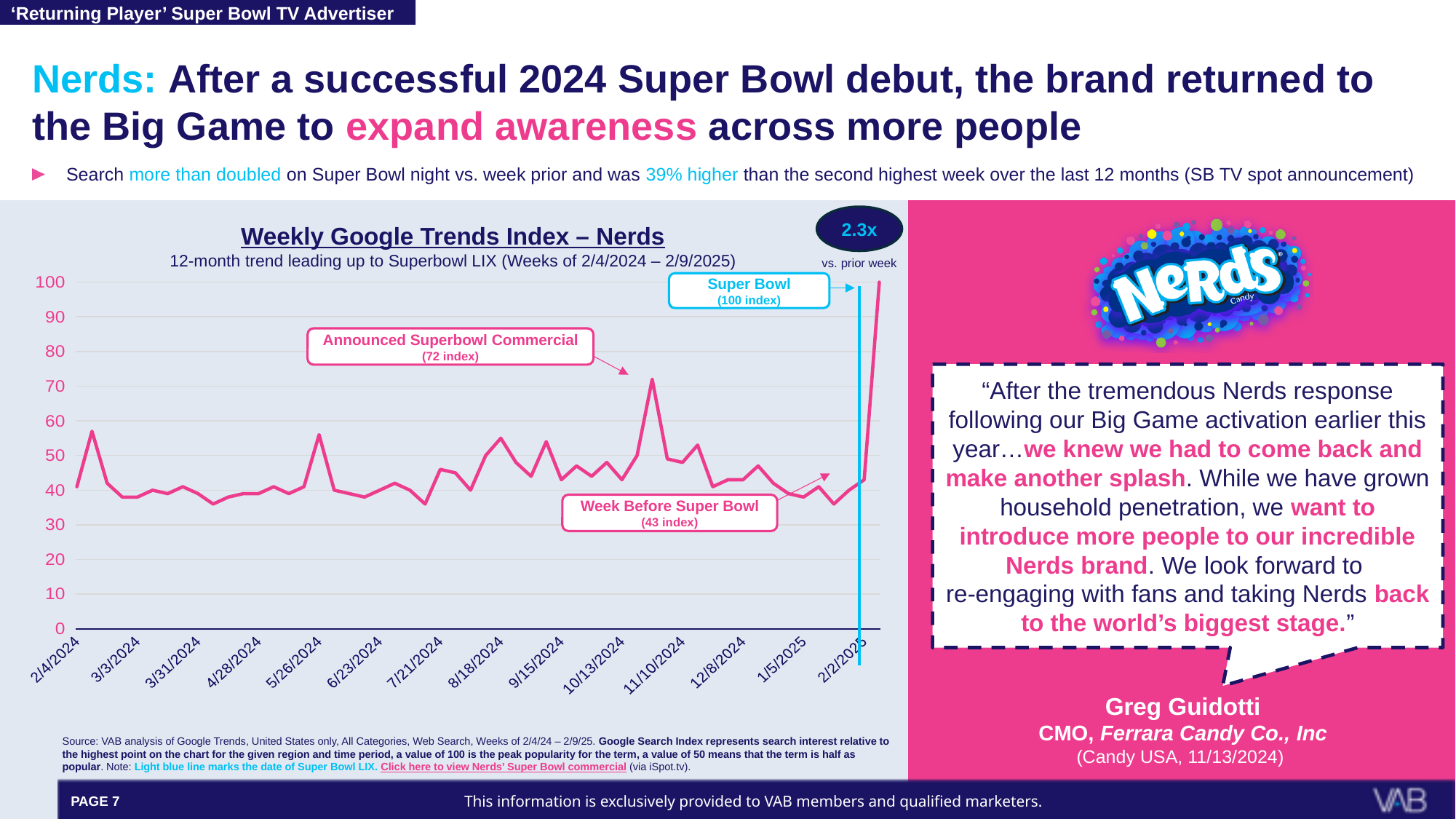
Is the index value for the week of 2/4/2024 greater or less than 50? less How many date labels are shown on the x axis of the chart? 14 What is the difference between the Super Bowl week index and the Announced Superbowl Commercial index? 28 By how much does the Super Bowl week index exceed the week-before-Super-Bowl index? 57 Which week has the highest Google Trends index on the chart? Super Bowl week What index value is shown for the week before the Super Bowl? 43 What kind of chart is the Weekly Google Trends Index – Nerds chart? line chart What index value is shown for the week the Superbowl commercial was announced? 72 According to the note, what does the light blue vertical line on the chart mark? the date of Super Bowl LIX What is the Google Trends index value for the Super Bowl week? 100 Does the index rise or fall from the week before the Super Bowl to the Super Bowl week? rise Which is higher: the index for the Announced Superbowl Commercial week or the Week Before Super Bowl? Announced Superbowl Commercial